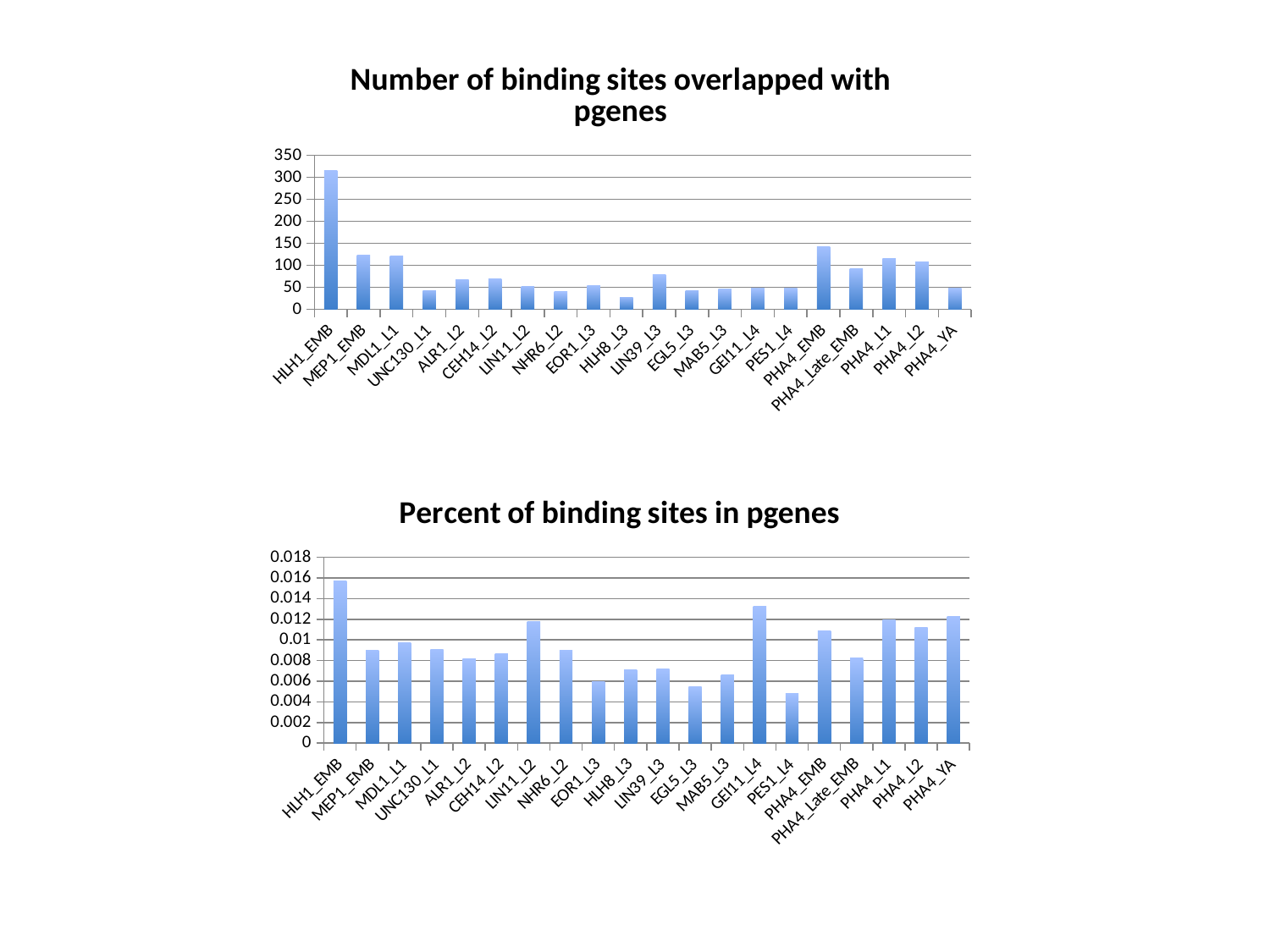
In the bottom chart, 'Percent of binding sites in pgenes', which is larger, the value for LIN11_L2 or the value for EOR1_L3? LIN11_L2 What kind of chart is the bottom chart, 'Percent of binding sites in pgenes'? bar chart How many categories are shown on the x axis of the top chart, 'Number of binding sites overlapped with pgenes'? 20 In the top chart, 'Number of binding sites overlapped with pgenes', which category has the highest value? HLH1_EMB In the bottom chart, 'Percent of binding sites in pgenes', is the value for PES1_L4 greater or less than 0.006? less In the top chart, 'Number of binding sites overlapped with pgenes', which category has the lowest value? HLH8_L3 In the top chart, 'Number of binding sites overlapped with pgenes', is the value for HLH8_L3 greater or less than 50? less In the top chart, 'Number of binding sites overlapped with pgenes', is the value for HLH1_EMB greater or less than 300? greater In the bottom chart, 'Percent of binding sites in pgenes', which category has the lowest value? PES1_L4 In the bottom chart, 'Percent of binding sites in pgenes', which category has the highest value? HLH1_EMB In the top chart, 'Number of binding sites overlapped with pgenes', which is larger, the value for PHA4_EMB or the value for UNC130_L1? PHA4_EMB